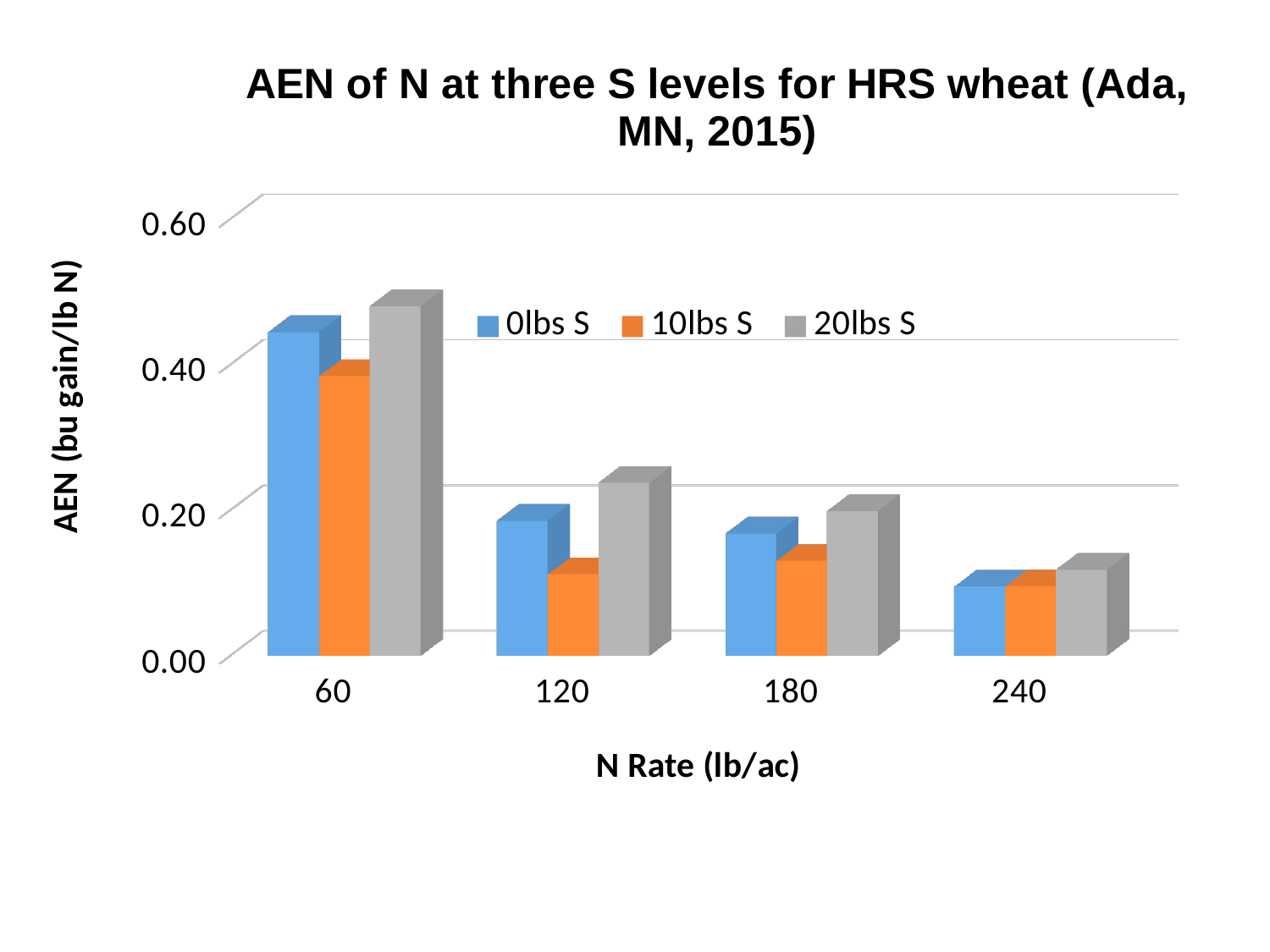
What kind of chart is shown on the slide? bar chart Does the AEN for the 0lbs S series rise or fall as the N rate increases from 60 to 240? fall Is the value for 20lbs S at the 60 lb/ac N rate greater or less than 0.40? greater At the 120 lb/ac N rate, which is larger: the 10lbs S bar or the 20lbs S bar? 20lbs S How many N rate categories are shown on the x axis? 4 How many series does the legend list? 3 What is the label of the y axis? AEN (bu gain/lb N) Is the value for 0lbs S at the 180 lb/ac N rate greater or less than 0.20? less Is the value for 10lbs S at the 120 lb/ac N rate greater or less than 0.20? less Which series has the tallest bar at the 60 lb/ac N rate? 20lbs S Which N rate has the lowest AEN for the 20lbs S series? 240 Which N rate has the highest AEN for the 0lbs S series? 60